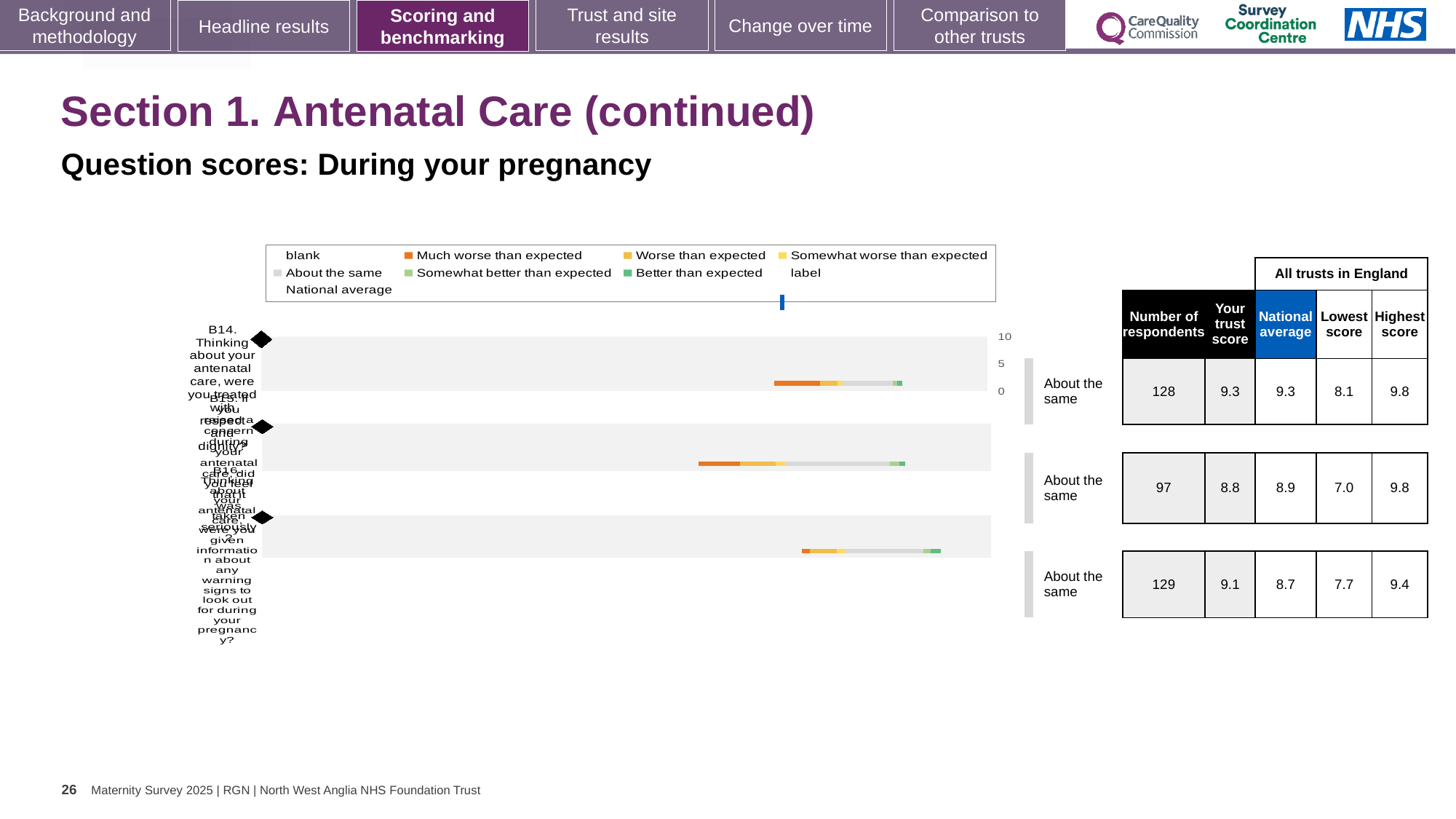
In the table next to the chart, what is the trust score for the second row? 8.8 What benchmark category is shown for all three questions beside the chart? About the same What is the highest tick value shown on the chart's axis? 10 In the table next to the chart, what is the national average for the third row? 8.7 Which legend entry is shown in orange as the most negative category? Much worse than expected How many entries does the chart legend list? 9 How many question bars are plotted in the chart? 3 What kind of chart is shown on the slide? bar chart In the table next to the chart, is the trust score in the second row larger or smaller than the national average in that row? smaller In the table next to the chart, what is the number of respondents for the first row (B14)? 128 In the table next to the chart, which row has the lowest 'Lowest score' value? the second row (7.0) In the table next to the chart, what is the difference between the trust score and the national average in the third row? 0.4